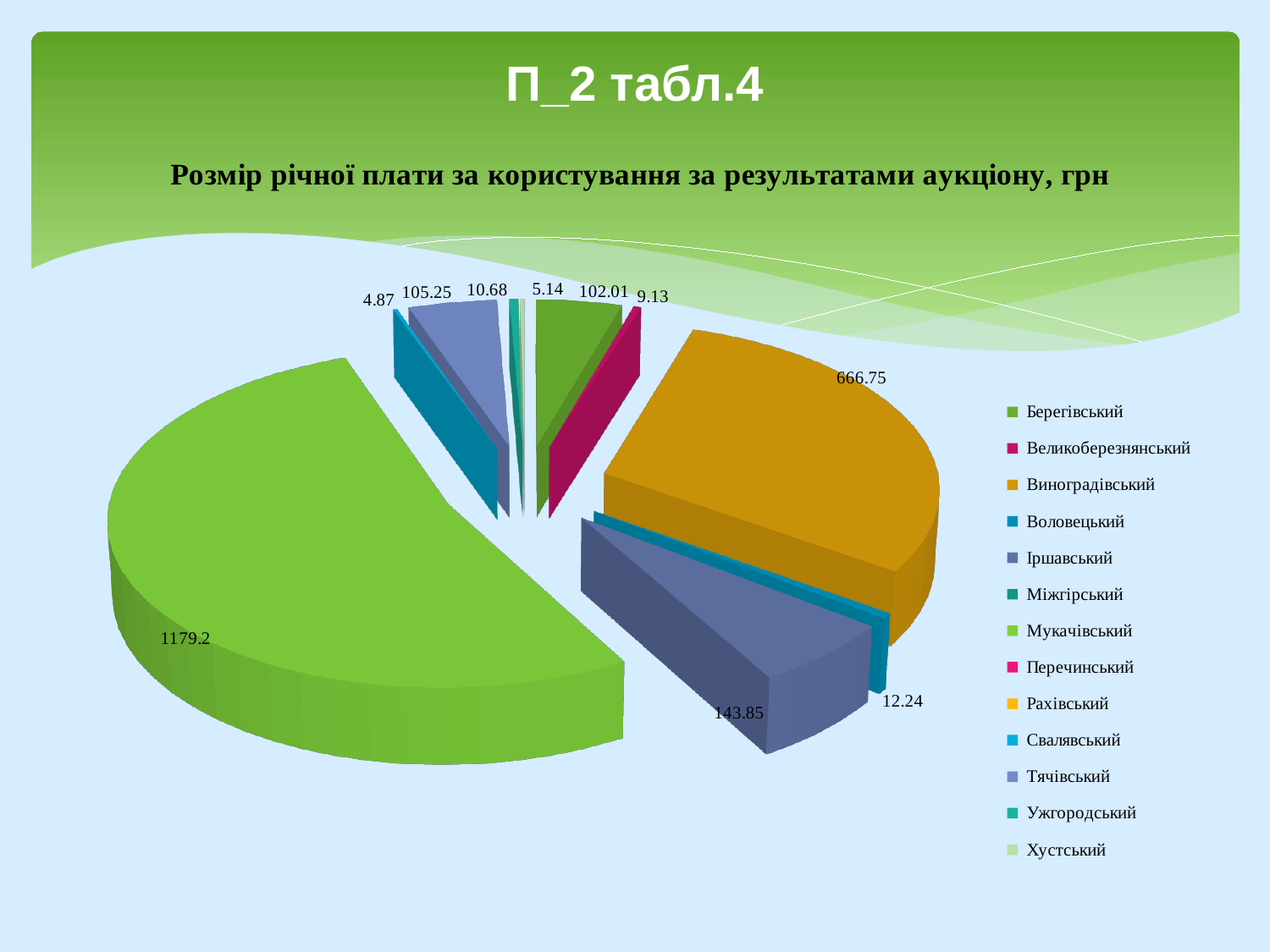
What kind of chart is shown on the slide? pie chart Which is larger, the value for Виноградівський or the value for Іршавський? Виноградівський What is the value for Берегівський? 102.01 What is the value for Іршавський? 143.85 What is the value for Воловецький? 12.24 What colour is the slice for Виноградівський? orange How many categories does the legend list? 13 What is the difference between the values for Мукачівський and Виноградівський? 512.45 What is the value for Мукачівський? 1179.2 Which category has the largest slice of the pie? Мукачівський What is the value for Виноградівський? 666.75 What is the title of the chart? Розмір річної плати за користування за результатами аукціону, грн